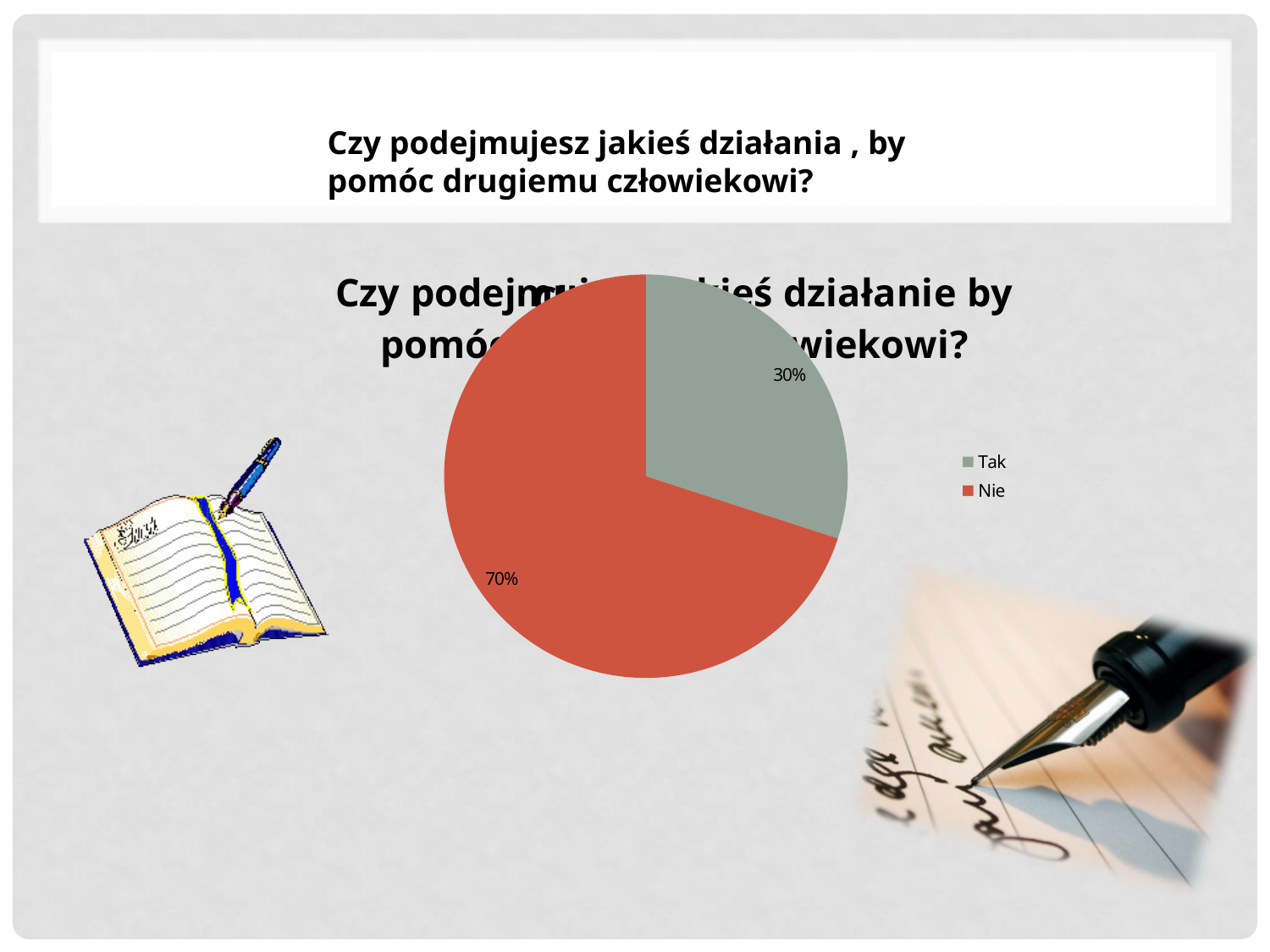
Which slice of the pie chart is the largest? Nie Which is larger, the "Tak" slice or the "Nie" slice? Nie How many entries does the legend of the pie chart list? 2 What colour is the "Tak" slice in the pie chart? grey-green What colour is the "Nie" slice in the pie chart? red What percentage of the pie chart is labelled for "Nie"? 70% Which slice of the pie chart is the smallest? Tak What kind of chart is shown on the slide? pie chart What share of the pie does the "Tak" slice represent? 30% What percentage of the pie chart is labelled for "Tak"? 30% What is the difference in percentage points between the "Nie" and "Tak" slices? 40 How many slices does the pie chart have? 2